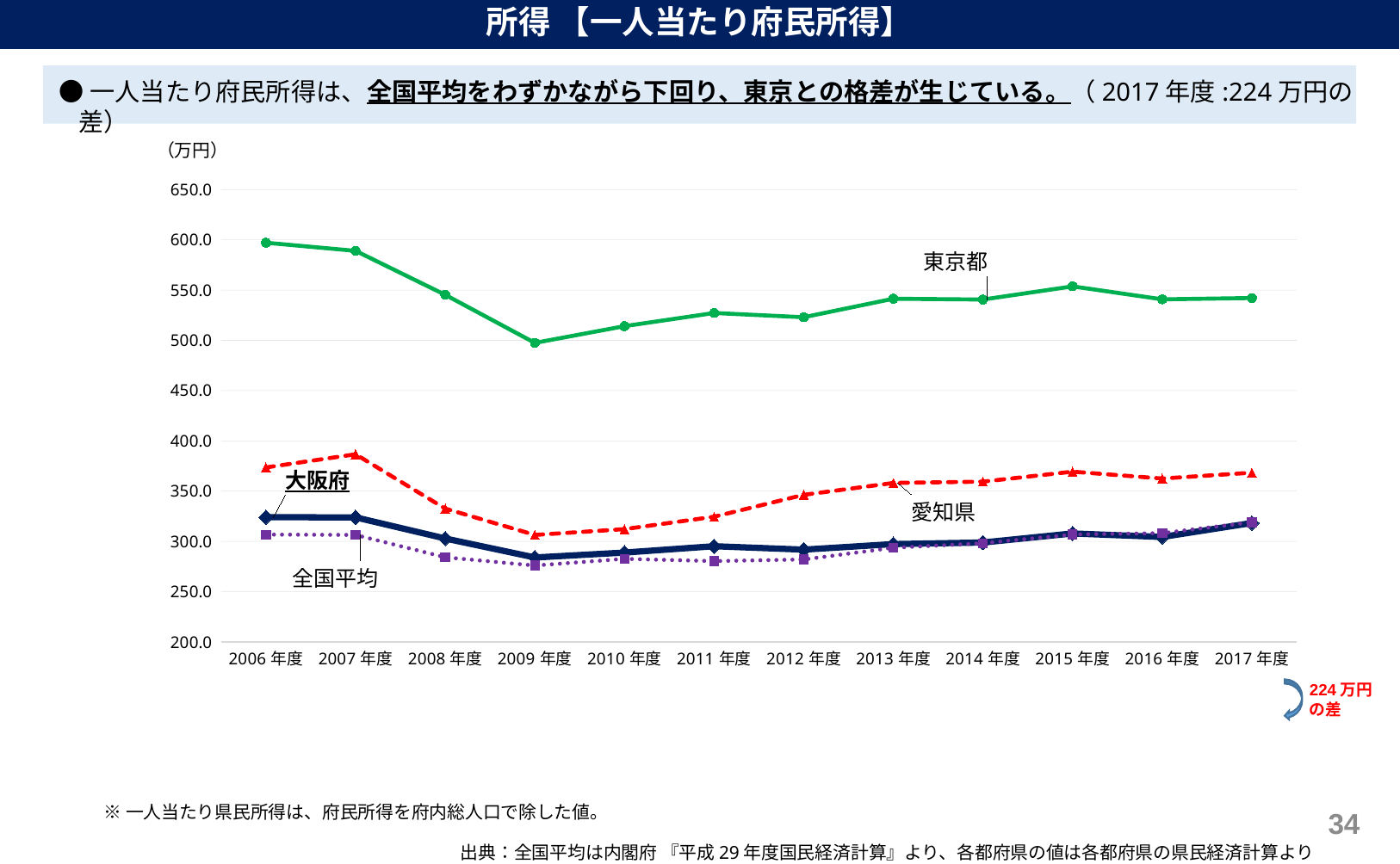
How many series are plotted in the chart? 4 What unit is shown at the top of the y axis? 万円 Is the value for 東京都 in 2009年度 greater or less than 550.0? less Which series has the lowest value in 2006年度? 全国平均 Does the 東京都 line rise or fall from 2006年度 to 2009年度? fall What kind of chart is shown on the slide? line chart How many fiscal years are plotted along the x axis? 12 Which series has the highest value in 2017年度? 東京都 Is the value for 大阪府 in 2009年度 greater or less than 300.0? less Is the value for 愛知県 in 2007年度 greater or less than 350.0? greater In 2012年度, which is larger: 愛知県 or 大阪府? 愛知県